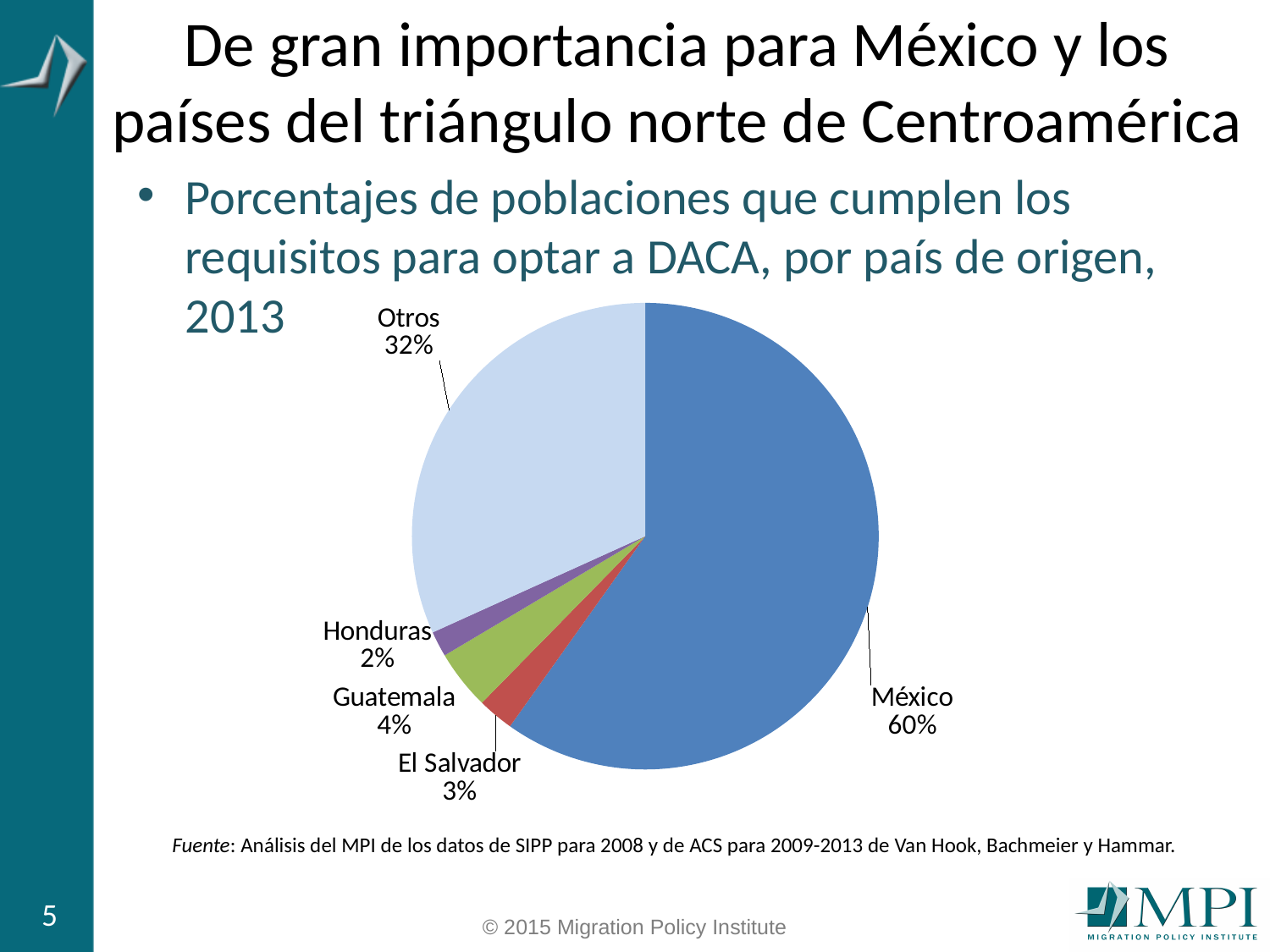
What is the combined share of Guatemala, El Salvador and Honduras? 9% Which country or category has the largest slice of the pie? México Which country or category has the smallest slice of the pie? Honduras What is the difference in percentage points between México and Otros? 28 What is the value shown for El Salvador? 3% What is the value shown for Honduras? 2% What share of the pie does México account for? 60% What is the value shown for Guatemala? 4% Which is larger, the share for Guatemala or the share for El Salvador? Guatemala What kind of chart is shown on the slide? Pie chart How many slices does the pie chart have? 5 What is the value shown for Otros? 32%